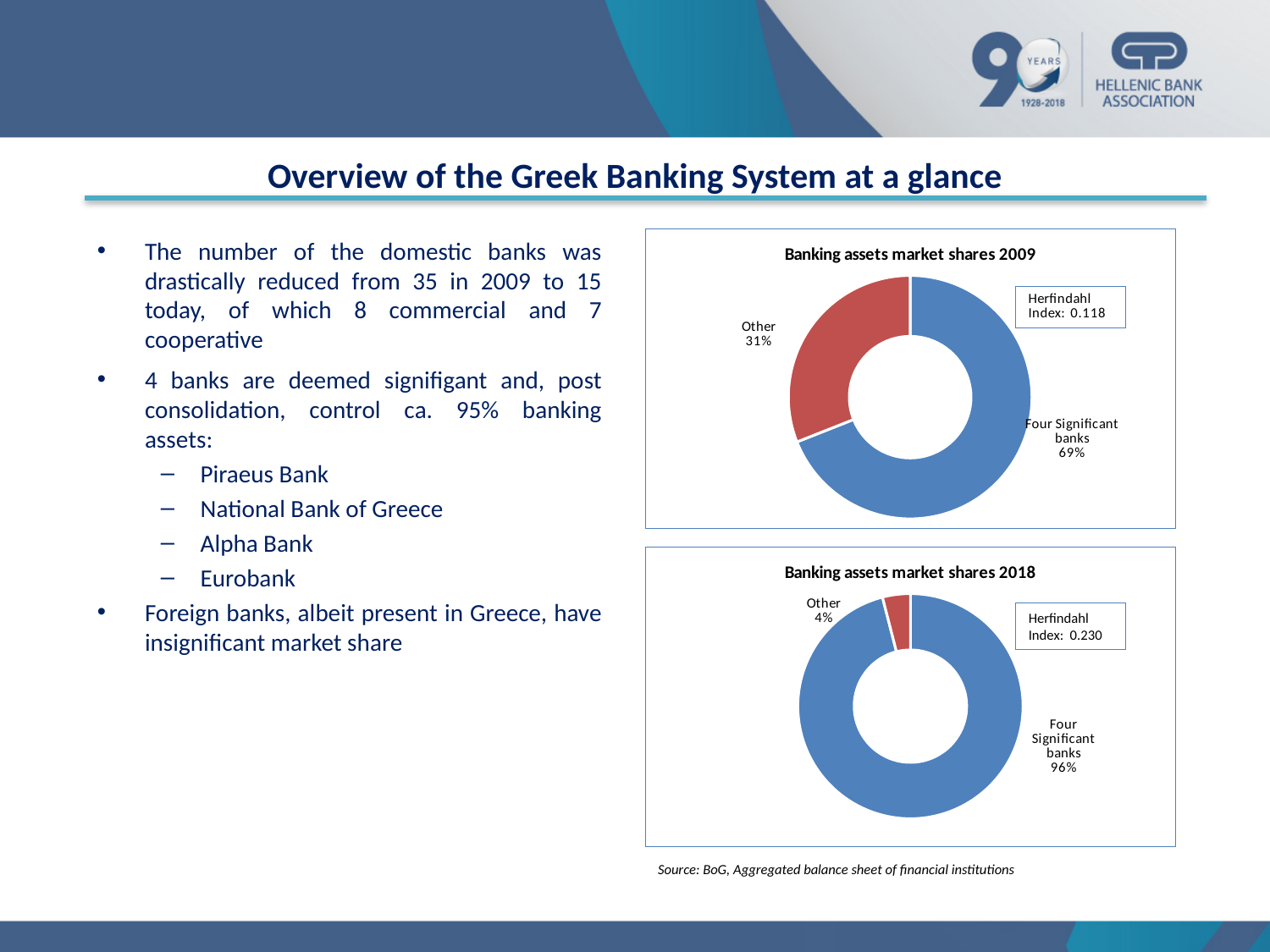
In the 'Banking assets market shares 2018' chart, what share is labelled 'Other'? 4% In the 'Banking assets market shares 2018' chart, what share do the Four Significant banks hold? 96% In the 'Banking assets market shares 2009' chart, what share do the Four Significant banks hold? 69% Is the Four Significant banks share larger in the 2009 chart or the 2018 chart? 2018 In the 'Banking assets market shares 2018' chart, which slice is the smallest? Other What kind of chart is 'Banking assets market shares 2018'? Pie chart (doughnut) In the 'Banking assets market shares 2009' chart, what share is labelled 'Other'? 31% In the 'Banking assets market shares 2009' chart, what is the difference between the Four Significant banks share and the Other share? 38% How many slices does the 'Banking assets market shares 2009' chart have? 2 In the 'Banking assets market shares 2009' chart, which slice is the largest? Four Significant banks What Herfindahl Index is shown on the 'Banking assets market shares 2009' chart? 0.118 What Herfindahl Index is shown on the 'Banking assets market shares 2018' chart? 0.230